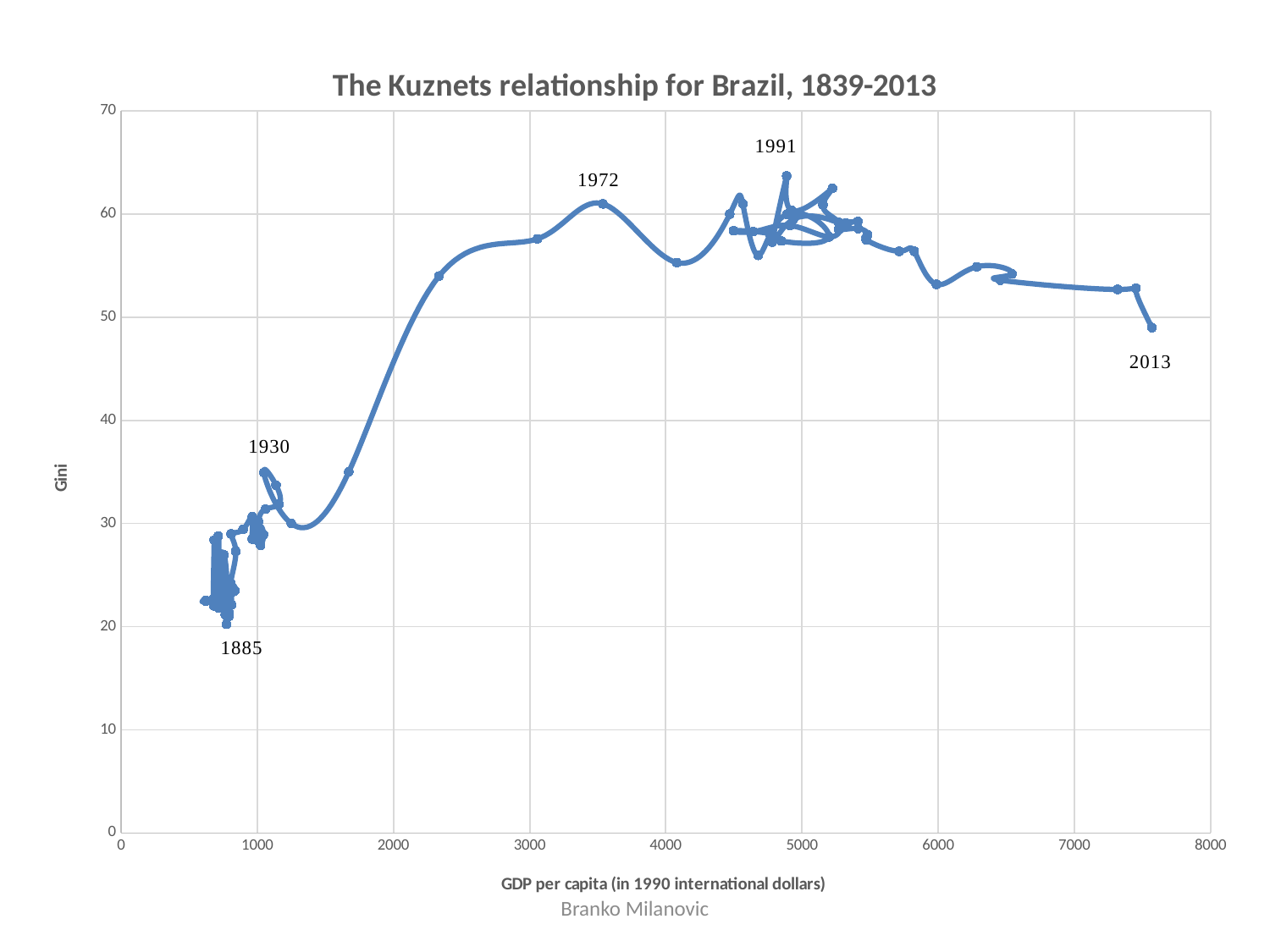
What is the title of the chart? The Kuznets relationship for Brazil, 1839-2013 Is the GDP per capita at the point labelled 2013 greater or less than 7000? greater Is the Gini value at the point labelled 1885 greater or less than 30? less Which labelled year has the higher Gini value, 1972 or 1885? 1972 What is the label of the x axis? GDP per capita (in 1990 international dollars) Is the Gini value at the point labelled 1930 greater or less than 30? greater What kind of chart is shown on the slide? scatter chart with smoothed lines Between the points labelled 1885 and 1972, does the Gini value rise or fall as GDP per capita increases? rise Of the labelled years (1885, 1930, 1972, 1991, 2013), which has the lowest Gini value? 1885